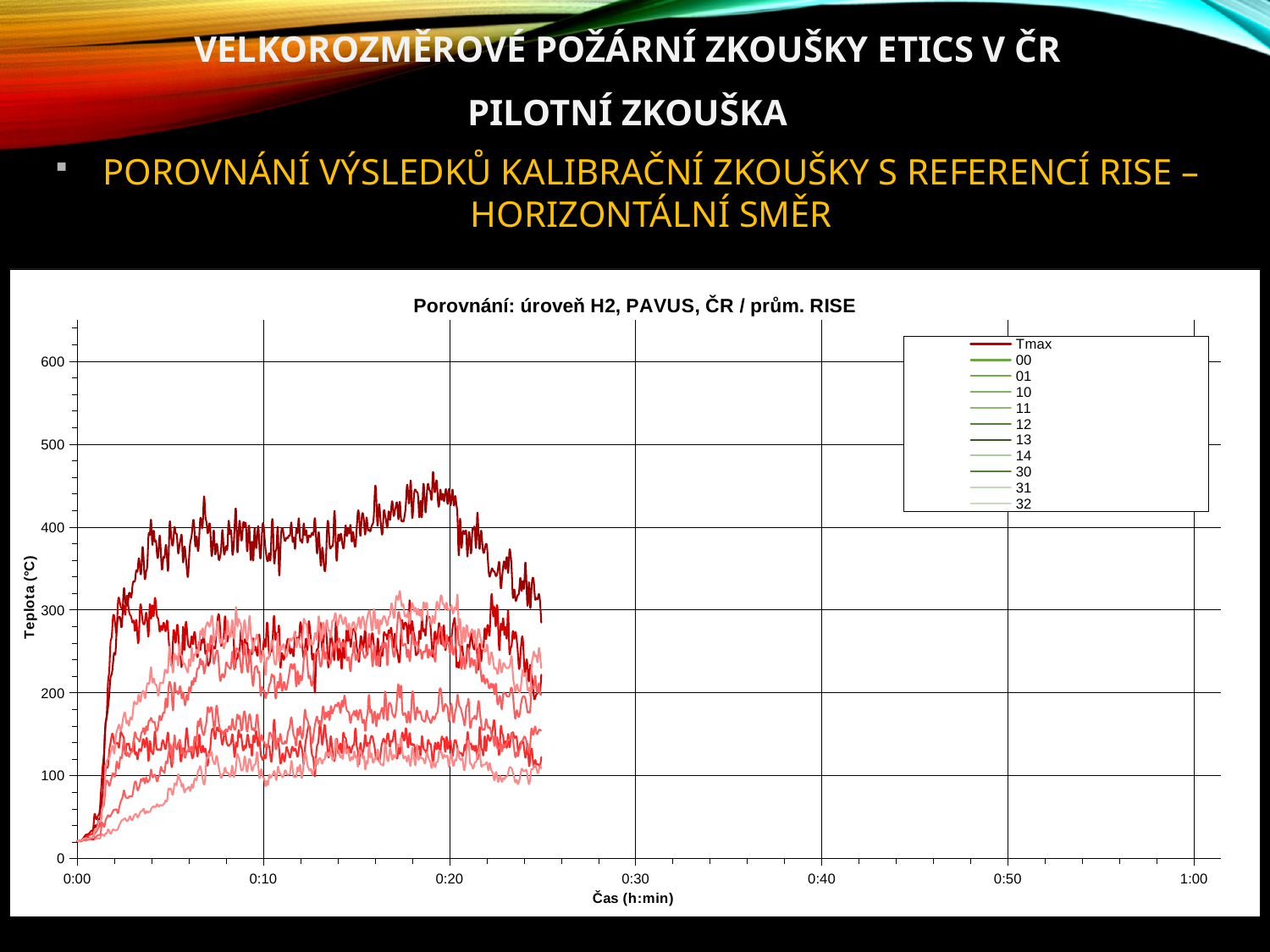
Which series reaches the highest temperature on the chart? Tmax What kind of chart is shown on the slide? line chart Is the highest temperature reached by the Tmax series greater or less than 400? greater How many labelled tick marks are there on the time axis of the chart? 7 Is the temperature of the series at time 0:00 greater or less than 100? less What is the title of the chart? Porovnání: úroveň H2, PAVUS, ČR / prům. RISE Is the time at which the plotted lines end greater or less than 0:30? less What is the label of the vertical axis of the chart? Teplota (°C) Do the temperatures rise or fall during the first few minutes of the test (from 0:00 to about 0:05)? rise How many series does the legend of the chart list? 11